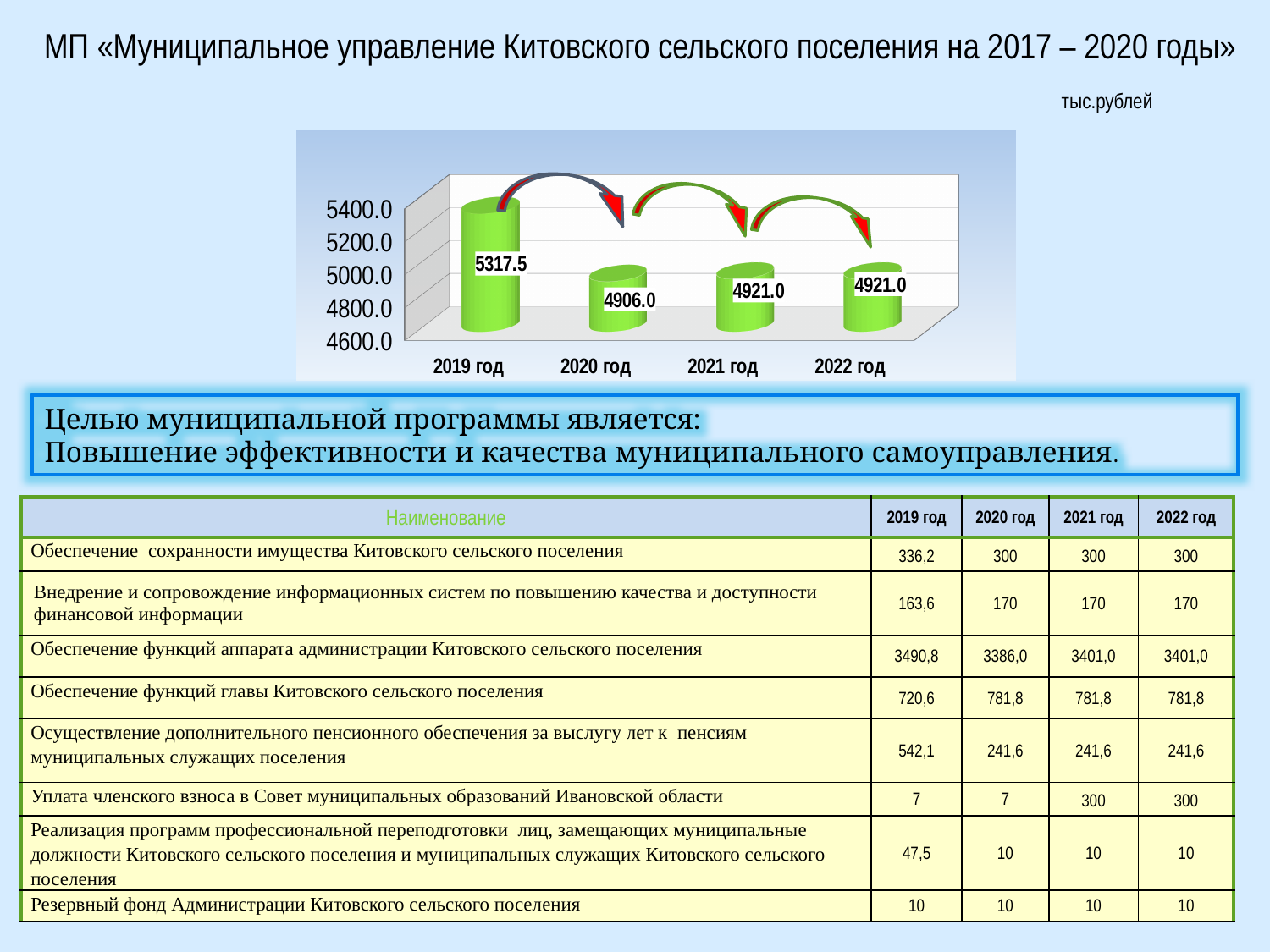
What kind of chart is shown on the slide? bar chart What is the difference between the values for 2021 год and 2020 год? 15.0 Which is larger, the value for 2019 год or the value for 2022 год? 2019 год What is the value shown for 2020 год in the chart? 4906.0 What is the value shown for 2019 год in the chart? 5317.5 What is the value shown for 2022 год in the chart? 4921.0 How many years are shown on the x axis of the chart? 4 Which year has the highest value in the chart? 2019 год Which year has the lowest value in the chart? 2020 год What is the difference between the values for 2019 год and 2020 год? 411.5 Does the value rise or fall from 2019 год to 2020 год? fall Is the value for 2019 год greater or less than 5200.0? greater